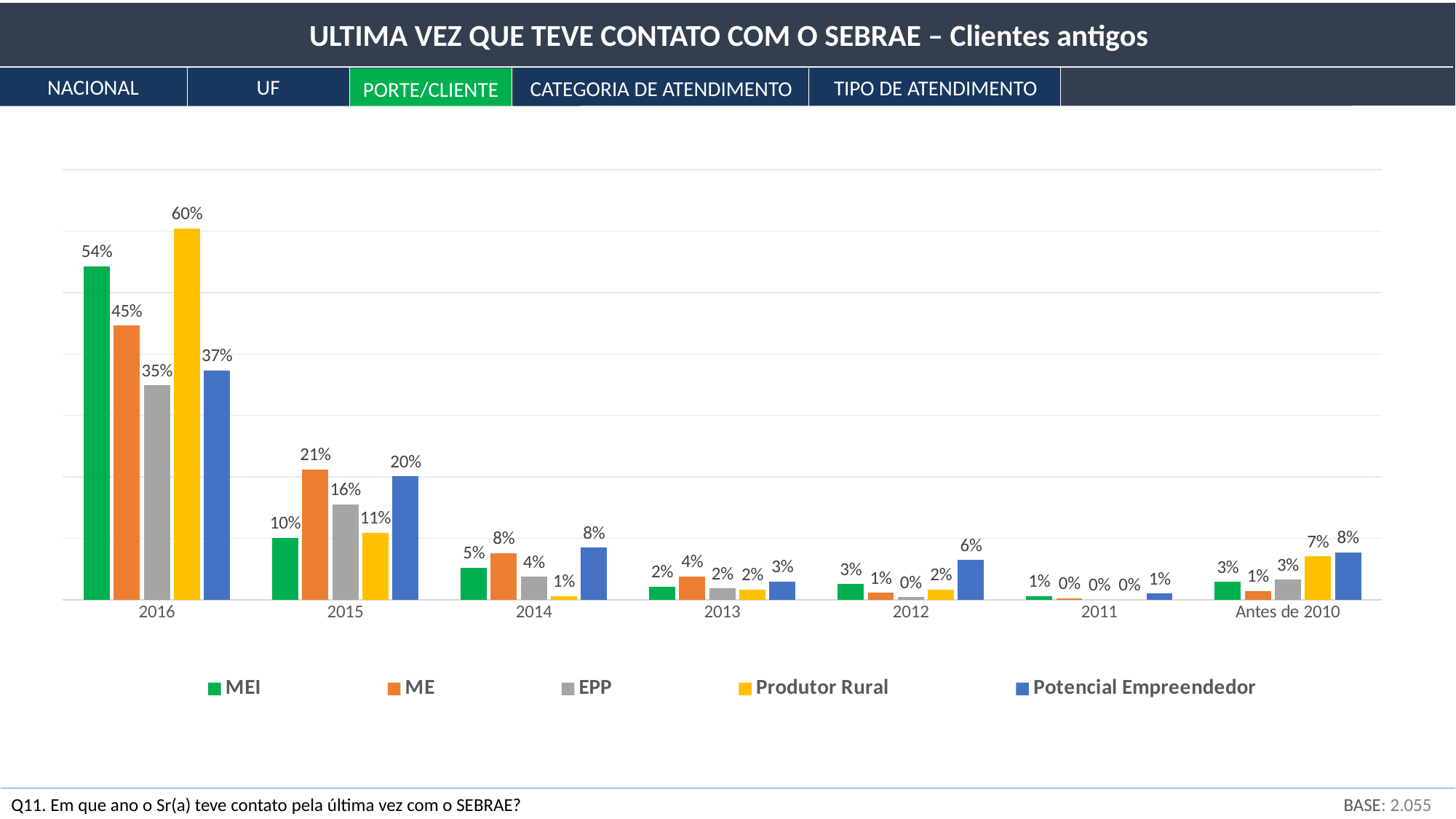
Which is larger in 2015, the value for ME or the value for Potencial Empreendedor? ME What is the value for MEI in 2015? 10% What is the difference between the MEI and ME values in 2016? 9% How many year categories are shown on the x axis? 7 What is the value for Potencial Empreendedor in 2012? 6% How many series does the legend list? 5 Which tab is highlighted in green in the navigation bar? PORTE/CLIENTE Which series has the lowest value in 2015? MEI What is the value for EPP in Antes de 2010? 3% What is the value for Produtor Rural in 2016? 60% What kind of chart is shown on the slide? Bar chart Which series has the highest value in 2016? Produtor Rural